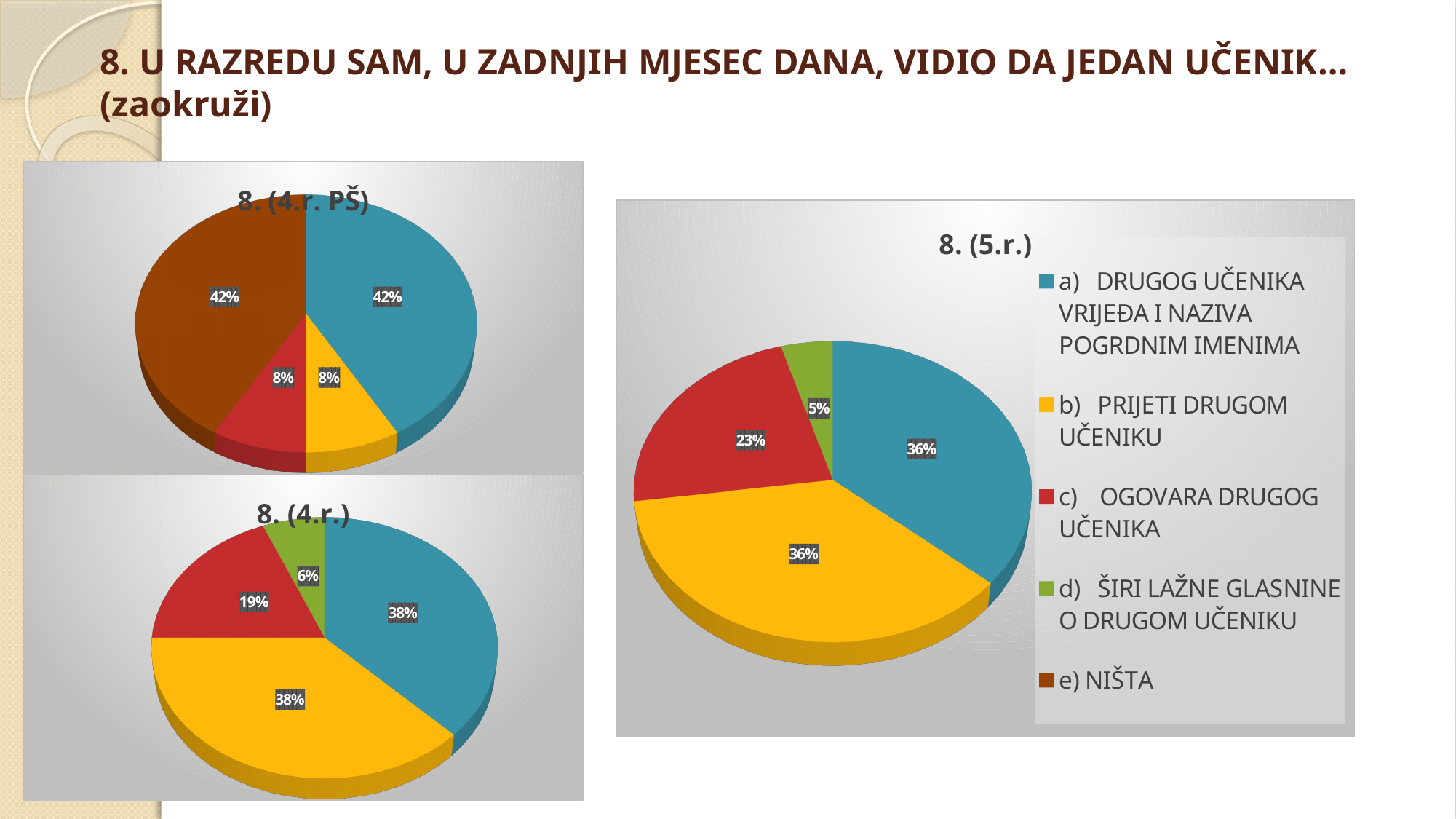
In the chart titled "8. (4.r.)", what is the difference between the blue slice and the red slice? 19% In the chart titled "8. (4.r. PŠ)", which is larger, the blue slice or the yellow slice? the blue slice In the chart titled "8. (5.r.)", what share is shown for "c) OGOVARA DRUGOG UČENIKA"? 23% In the chart titled "8. (5.r.)", how many entries does the legend list? 5 In the chart titled "8. (4.r. PŠ)", how many slices does the pie have? 4 In the chart titled "8. (4.r. PŠ)", what share is shown for the brown slice? 42% In the chart titled "8. (5.r.)", what share is shown for "b) PRIJETI DRUGOM UČENIKU"? 36% In the chart titled "8. (5.r.)", which category has the smallest slice? d) ŠIRI LAŽNE GLASNINE O DRUGOM UČENIKU In the chart titled "8. (4.r.)", what share is shown for the red slice? 19% In the chart titled "8. (4.r.)", what share is shown for the green slice? 6% What type of chart is the chart titled "8. (5.r.)"? pie chart In the chart titled "8. (5.r.)", what share is shown for "d) ŠIRI LAŽNE GLASNINE O DRUGOM UČENIKU"? 5%